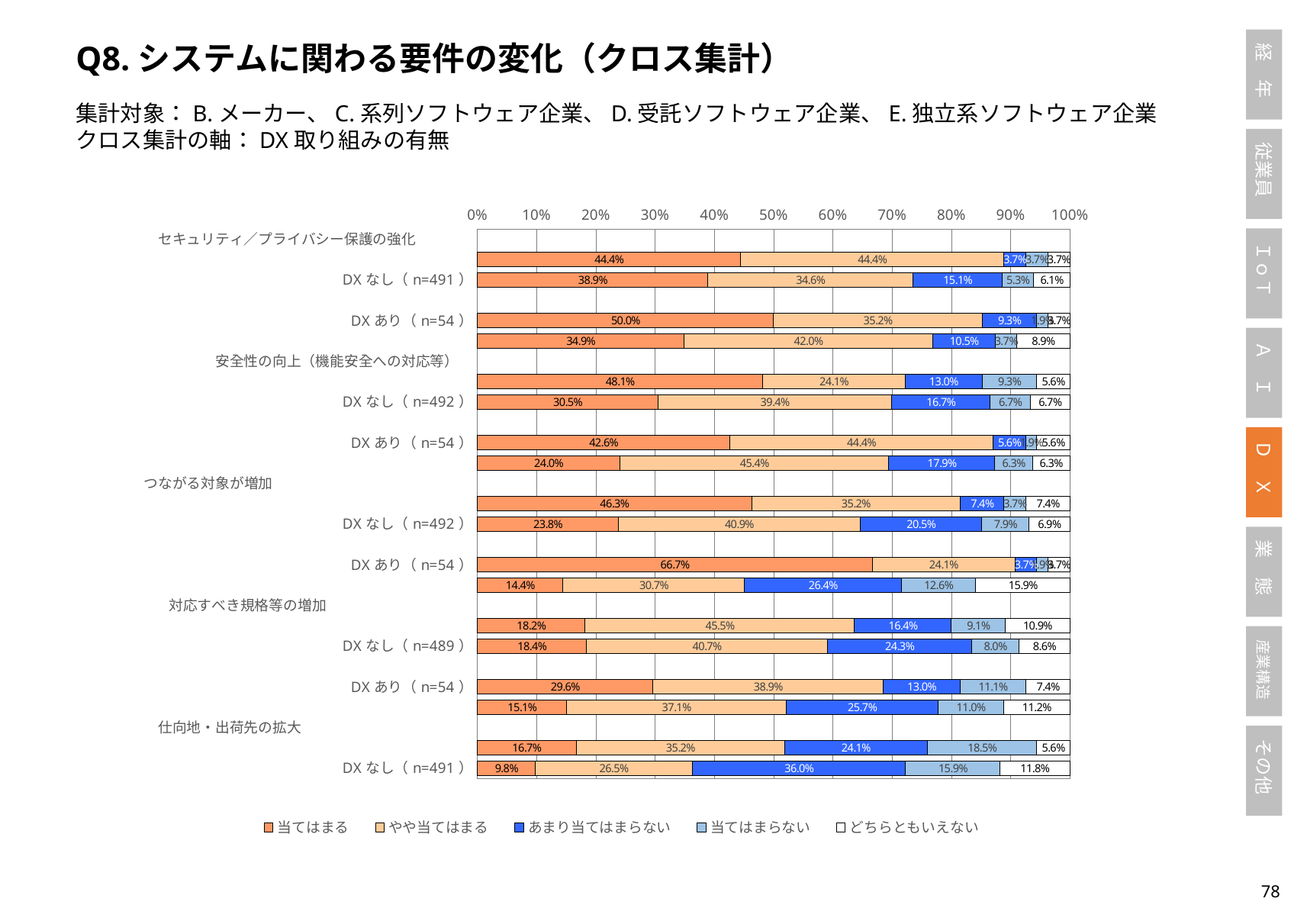
What is the 当てはまる value in the topmost bar? 44.4% How many series does the legend list? 5 What kind of chart is shown on the slide? Stacked horizontal bar chart What is the smallest 当てはまる value shown in any bar? 9.8% What is the highest value shown on the x axis? 100% What is the first legend entry (the dark orange series)? 当てはまる What is the あまり当てはまらない value in the bottom bar? 36.0% In the bottom bar, what is the difference between the あまり当てはまらない value and the 当てはまる value? 26.2 percentage points How many stacked bars are plotted in the chart? 18 What is the largest 当てはまる value shown in any bar? 66.7% Is the 当てはまる value in the bar labelled 66.7% greater or less than 60%? greater In the topmost bar, which is larger: the 当てはまる value or the あまり当てはまらない value? 当てはまる